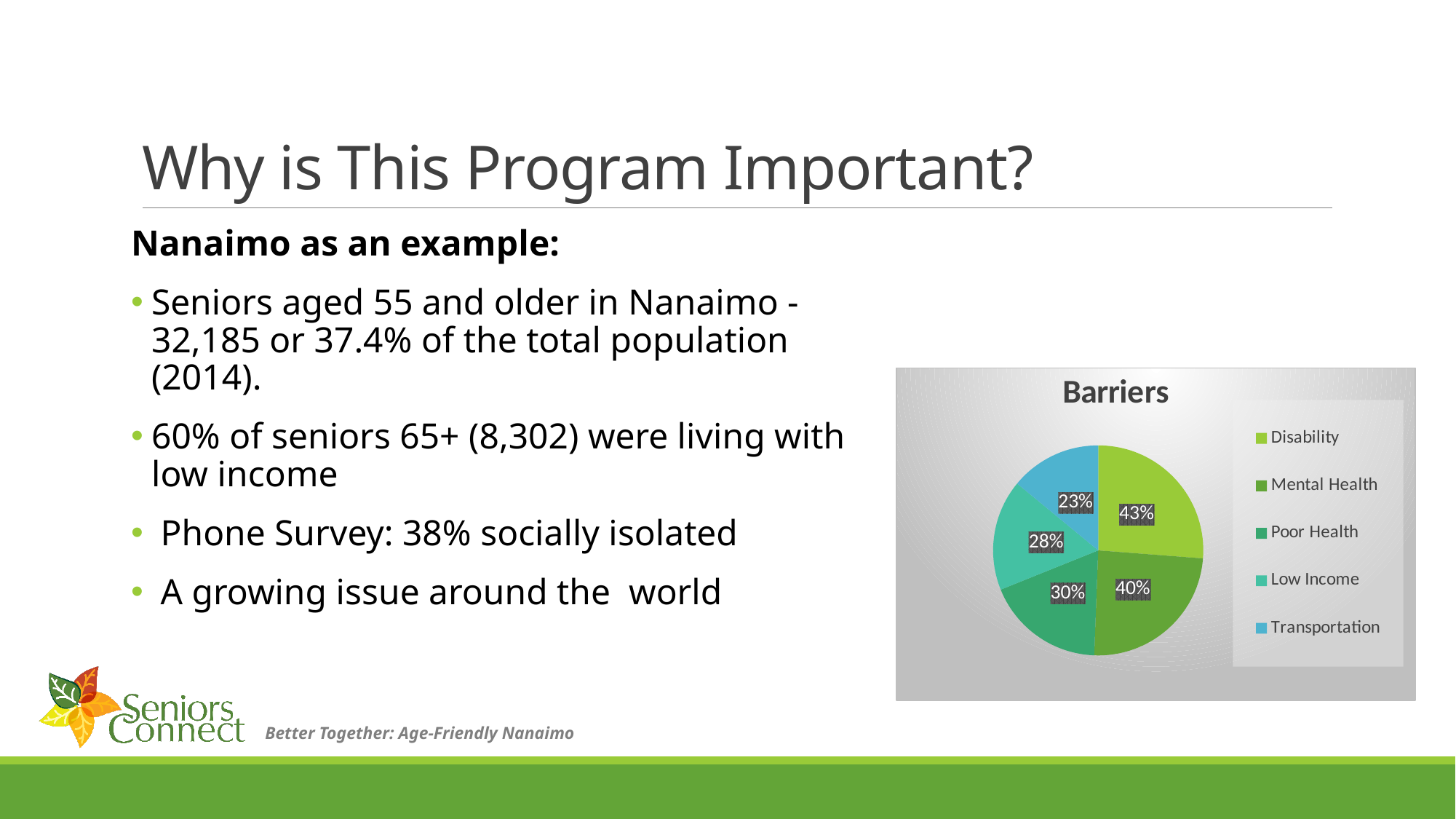
What is the difference between the labelled values for Disability and Transportation? 20% Which barrier has the highest labelled value? Disability Which barrier has the lowest labelled value? Transportation What value is labelled on the Poor Health slice? 30% Which has a larger labelled value, Poor Health or Low Income? Poor Health What value is labelled on the Transportation slice? 23% What value is labelled on the Low Income slice? 28% What value is labelled on the Mental Health slice? 40% What is the title of the chart? Barriers How many categories does the legend list? 5 What value is labelled on the Disability slice? 43% What type of chart is shown on the slide? pie chart